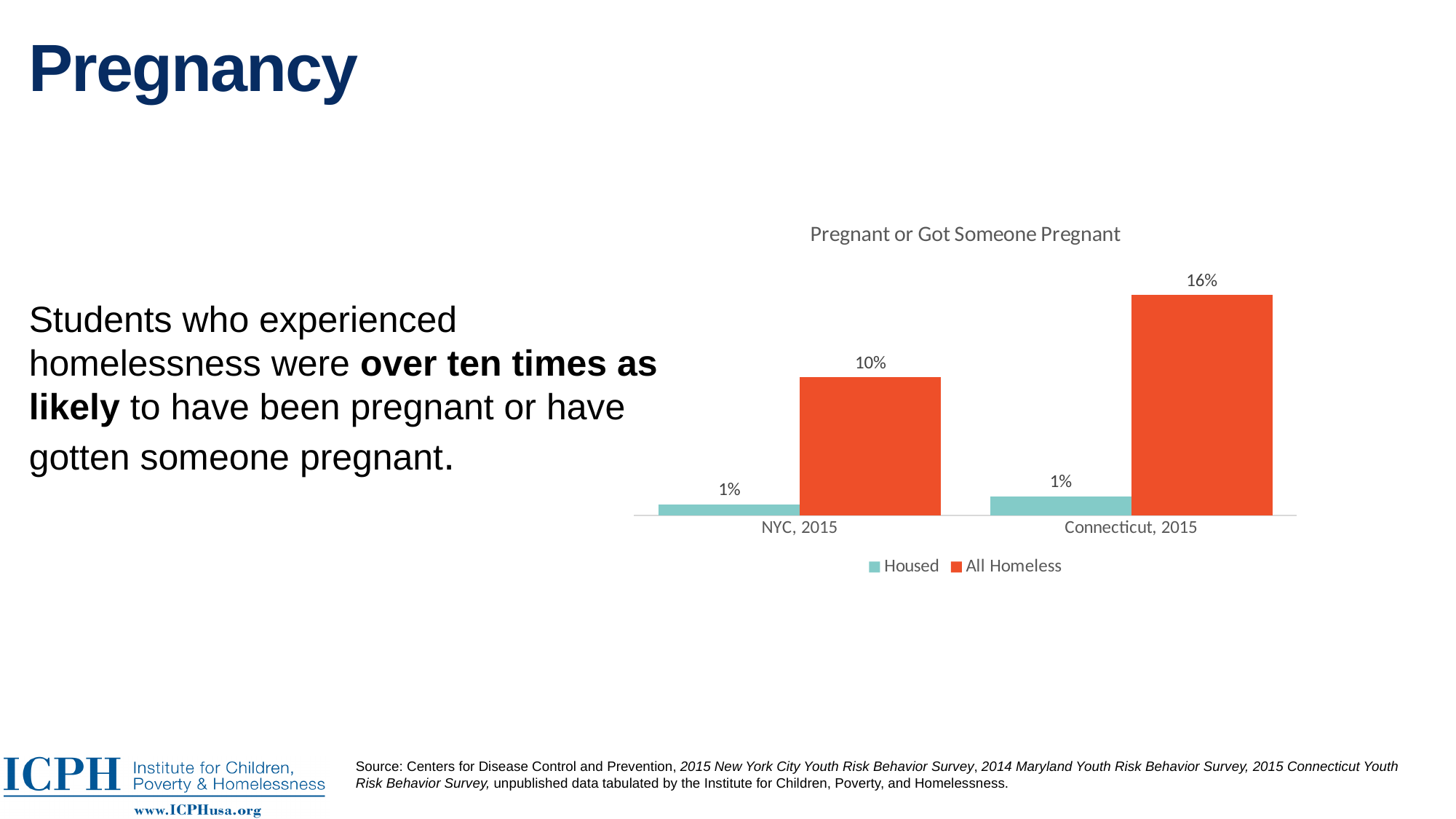
What is the value for Housed in Connecticut, 2015? 1% How many categories are shown on the x axis? 2 What is the value for All Homeless in Connecticut, 2015? 16% Which bar has the highest value in the chart? All Homeless, Connecticut, 2015 What is the title of the chart? Pregnant or Got Someone Pregnant How many series does the legend list? 2 What kind of chart is shown on the slide? Bar chart What is the value for Housed in NYC, 2015? 1% What is the difference between the All Homeless values for Connecticut, 2015 and NYC, 2015? 6% What is the value for All Homeless in NYC, 2015? 10% Which is larger in Connecticut, 2015: the Housed value or the All Homeless value? All Homeless What is the difference between the All Homeless and Housed values in NYC, 2015? 9%